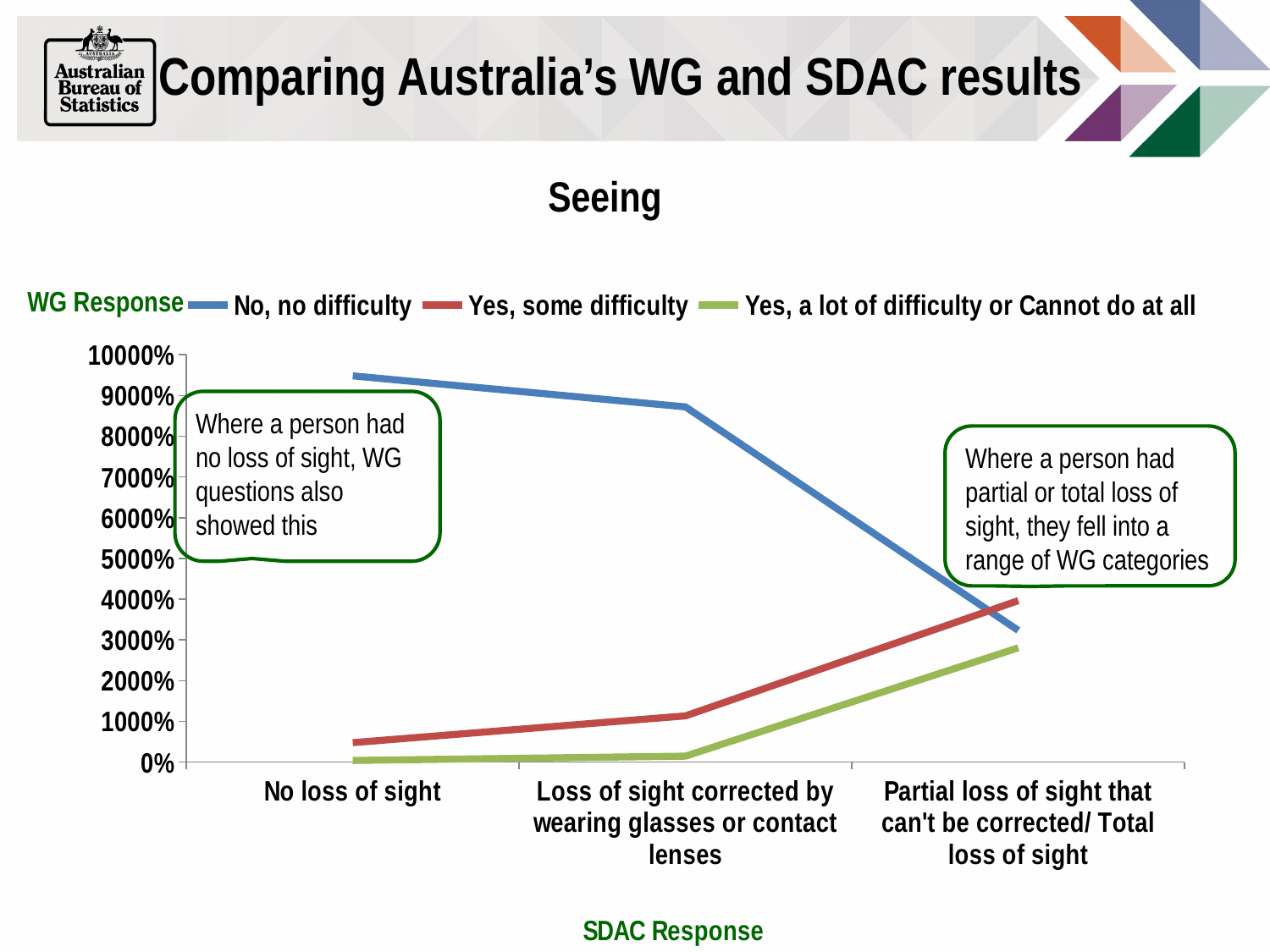
How many series does the legend list? 3 Is the value for 'Yes, a lot of difficulty or Cannot do at all' at 'Partial loss of sight that can't be corrected/ Total loss of sight' greater or less than 2000%? greater How many SDAC Response categories are shown on the x axis? 3 What kind of chart is shown on the slide? line chart Which series has the lowest value at 'No loss of sight'? Yes, a lot of difficulty or Cannot do at all Does the 'No, no difficulty' line rise or fall from left to right along the x axis? fall Is the value for 'No, no difficulty' at 'No loss of sight' greater or less than 9000%? greater Is the value for 'No, no difficulty' at 'Loss of sight corrected by wearing glasses or contact lenses' greater or less than 8000%? greater What is the title of the x axis? SDAC Response Does the 'Yes, some difficulty' line rise or fall from left to right along the x axis? rise Which series has the highest value at 'Partial loss of sight that can't be corrected/ Total loss of sight'? Yes, some difficulty